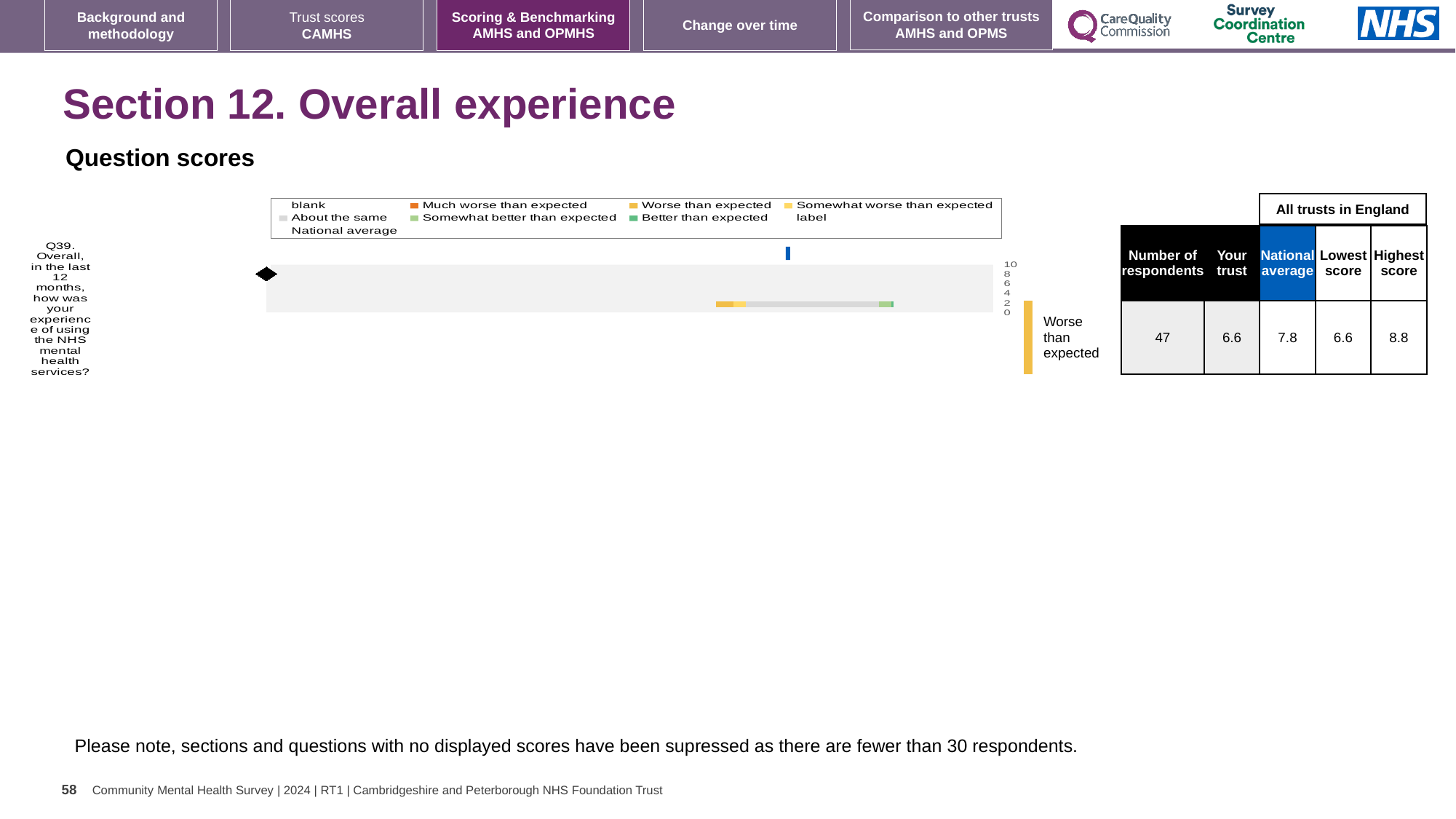
What is the national average score for Q39? 7.8 What benchmarking category is the trust's Q39 result labelled as? Worse than expected What is the 'Your trust' score for Q39? 6.6 How many questions are plotted in the Question scores chart? 1 How many respondents are shown for Q39 (Overall, in the last 12 months, how was your experience of using the NHS mental health services?)? 47 What is the difference between the national average and the 'Your trust' score for Q39? 1.2 Which is larger for Q39, the highest score or the national average? Highest score What is the difference between the highest score and the lowest score for Q39? 2.2 What kind of chart is used for the Question scores? Bar chart What is the highest score among all trusts in England for Q39? 8.8 Which is larger for Q39, the 'Your trust' score or the national average? National average What is the lowest score among all trusts in England for Q39? 6.6